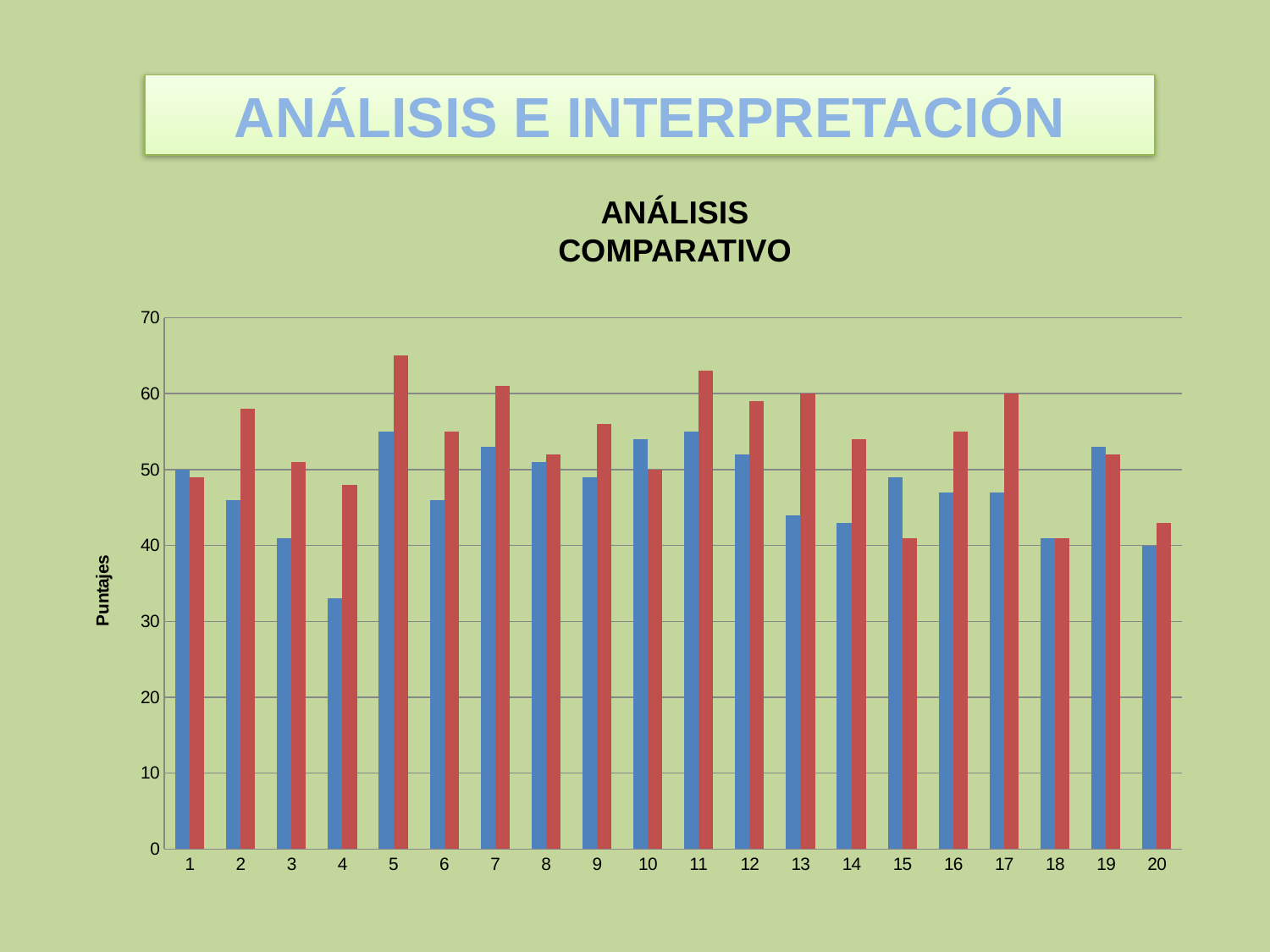
What is the title of the chart? ANÁLISIS COMPARATIVO What kind of chart is shown on the slide? Bar chart For category 15, which bar is taller, the blue one or the red one? Blue Is the red bar for category 2 greater or less than 50? greater Is the blue bar for category 4 greater or less than 40? less How many bars are plotted for each category in the chart? 2 For category 13, which bar is taller, the blue one or the red one? Red How many categories are shown along the x axis of the chart? 20 Is the blue bar for category 20 greater or less than 50? less Which category has the lowest blue bar? 4 What is the label on the vertical axis of the chart? Puntajes